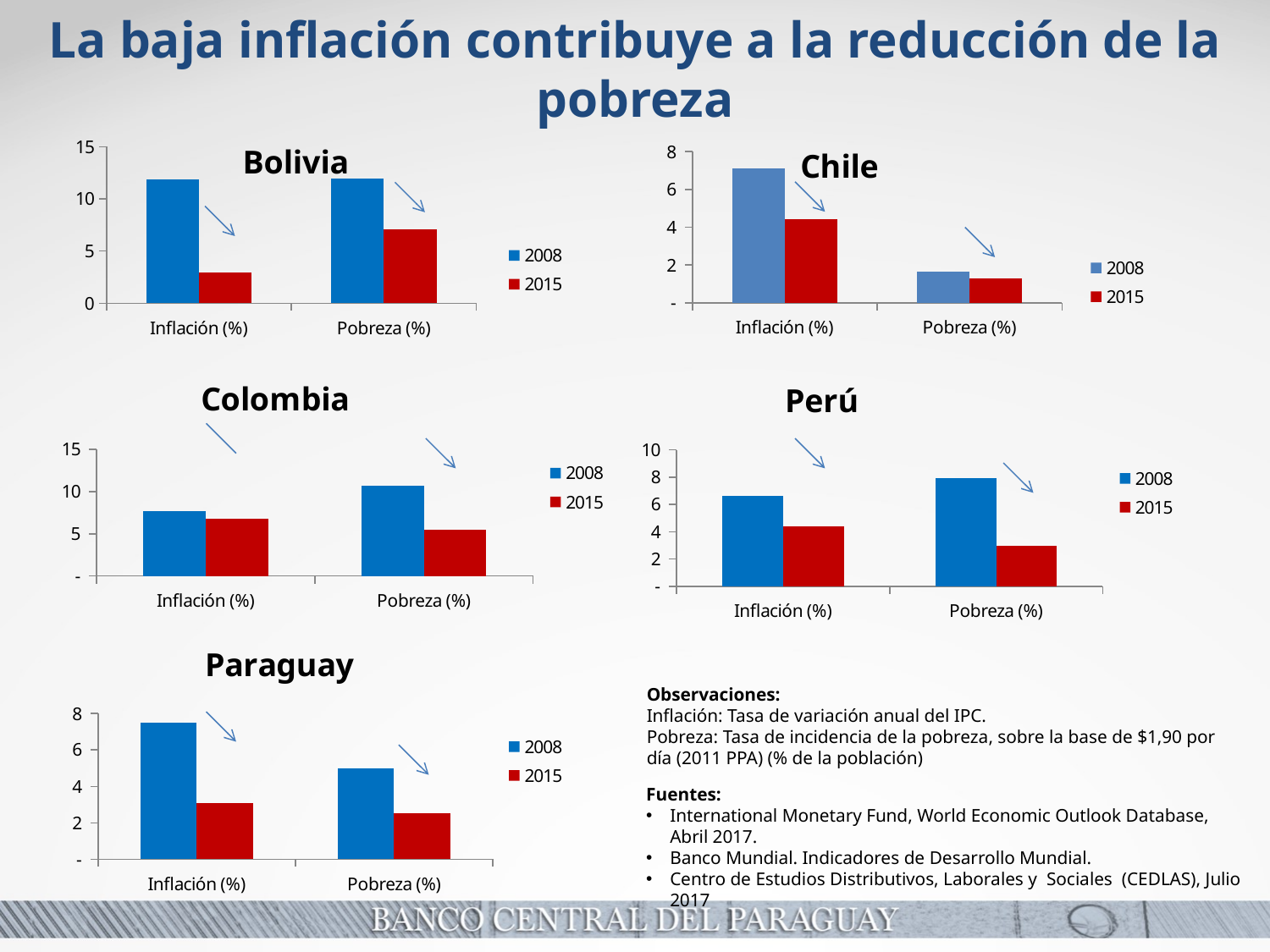
In the Paraguay chart, is the 2015 value for Pobreza (%) greater or less than 4? less In the Chile chart, is the 2008 value for Inflación (%) greater or less than 6? greater In the Paraguay chart, is the 2008 value for Inflación (%) greater or less than 6? greater How many categories are shown on the x axis of the Bolivia chart? 2 What kind of chart is the Chile chart? bar chart In the Colombia chart, which category has the larger 2008 value, Inflación (%) or Pobreza (%)? Pobreza (%) How many series does the legend of the Paraguay chart list? 2